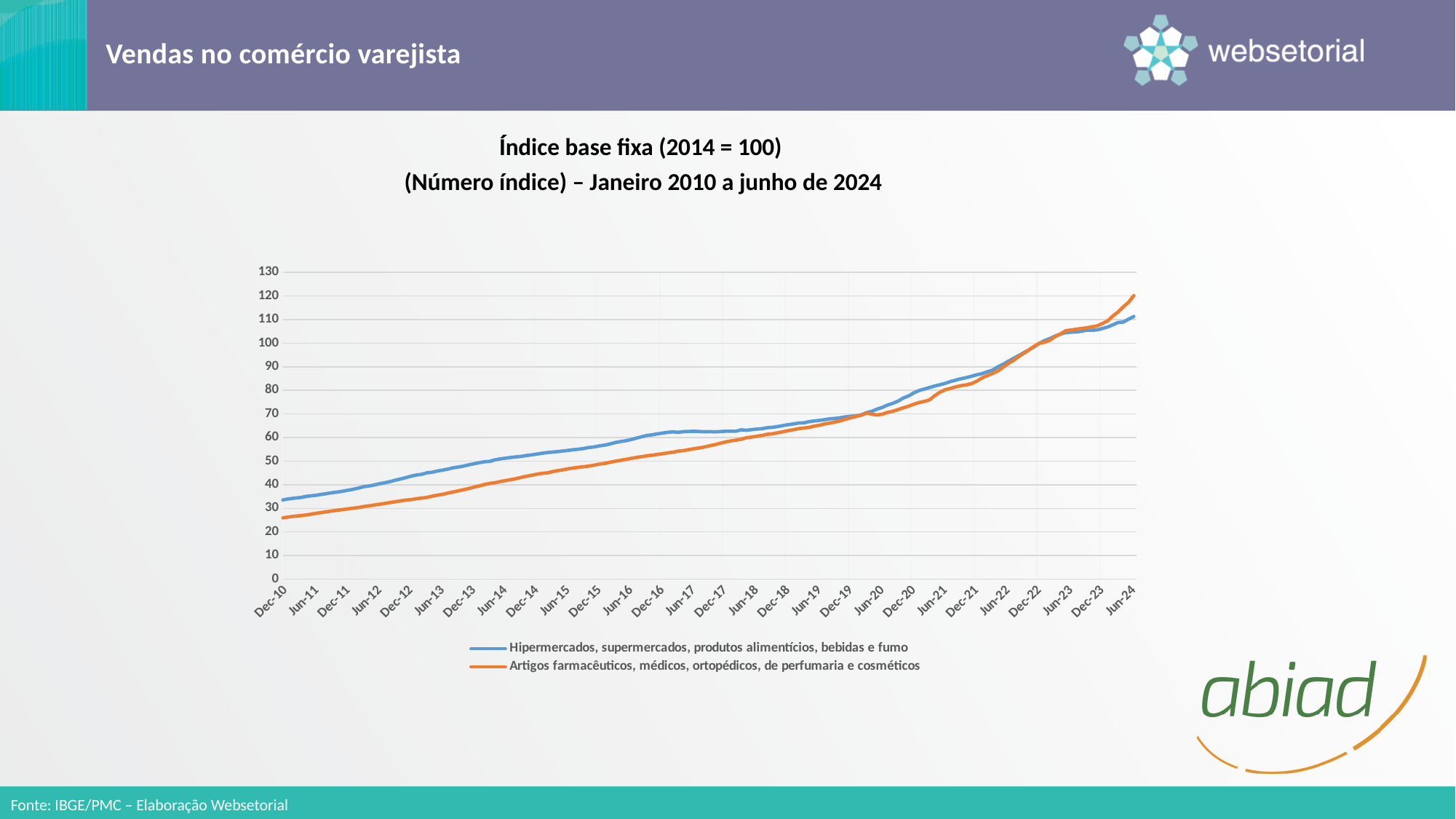
What kind of chart is shown on the slide? Line chart Is the value for 'Artigos farmacêuticos, médicos, ortopédicos, de perfumaria e cosméticos' at Jun-24 greater or less than 110? greater How many series does the legend list? 2 Is the value for 'Hipermercados, supermercados, produtos alimentícios, bebidas e fumo' at Jun-24 greater or less than 100? greater Do the values of the 'Artigos farmacêuticos, médicos, ortopédicos, de perfumaria e cosméticos' series rise or fall over the period shown? Rise At Dec-10, which series has the higher value? Hipermercados, supermercados, produtos alimentícios, bebidas e fumo Do the values of the 'Hipermercados, supermercados, produtos alimentícios, bebidas e fumo' series rise or fall from Dec-10 to Jun-24? Rise Is the value for 'Hipermercados, supermercados, produtos alimentícios, bebidas e fumo' at Dec-10 greater or less than 30? greater What is the title of the chart? Índice base fixa (2014 = 100) (Número índice) – Janeiro 2010 a junho de 2024 Which colour is used for the series 'Artigos farmacêuticos, médicos, ortopédicos, de perfumaria e cosméticos'? Orange At Jun-24, which series has the higher value? Artigos farmacêuticos, médicos, ortopédicos, de perfumaria e cosméticos